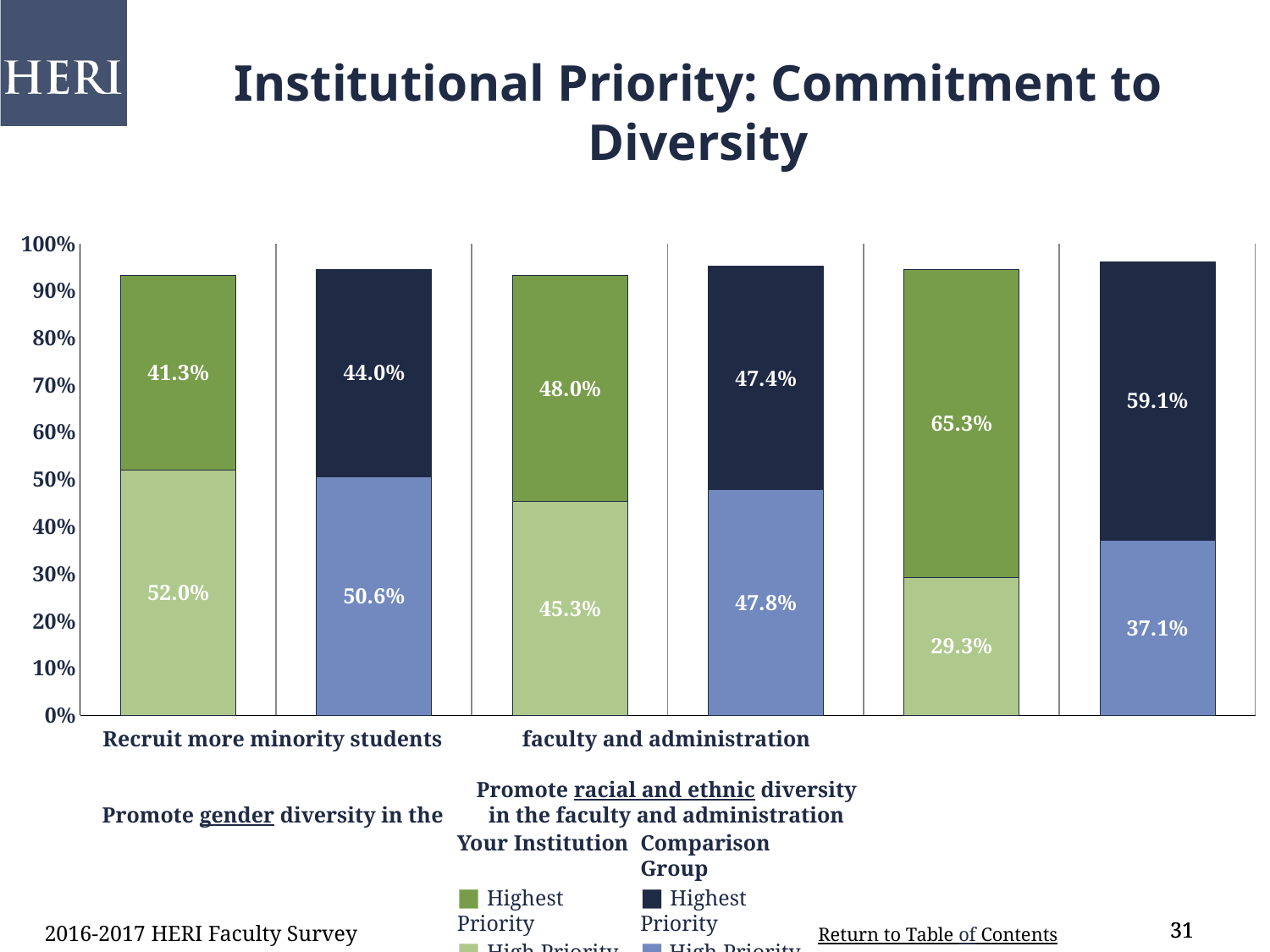
What type of chart is shown on the slide? Stacked bar chart What is the combined total of High Priority and Highest Priority for the Comparison Group on 'Promote racial and ethnic diversity in the faculty and administration'? 96.2% Which item has the highest Highest Priority value for Your Institution? Promote racial and ethnic diversity in the faculty and administration What is the High Priority value for the Comparison Group on 'Promote racial and ethnic diversity in the faculty and administration'? 37.1% What is the Highest Priority value for Your Institution on 'Promote racial and ethnic diversity in the faculty and administration'? 65.3% What is the High Priority value for the Comparison Group on 'Promote gender diversity in the faculty and administration'? 47.8% Which item has the lowest High Priority value for the Comparison Group? Promote racial and ethnic diversity in the faculty and administration What percentage of faculty at Your Institution rated 'Recruit more minority students' as the Highest Priority? 41.3% What colour represents Highest Priority for the Comparison Group? Dark navy blue What is the combined total of High Priority and Highest Priority for Your Institution on 'Recruit more minority students'? 93.3% What is the difference between the Highest Priority values for Your Institution and the Comparison Group on 'Promote racial and ethnic diversity in the faculty and administration'? 6.2% For 'Recruit more minority students', which is larger: the High Priority value for Your Institution or for the Comparison Group? Your Institution